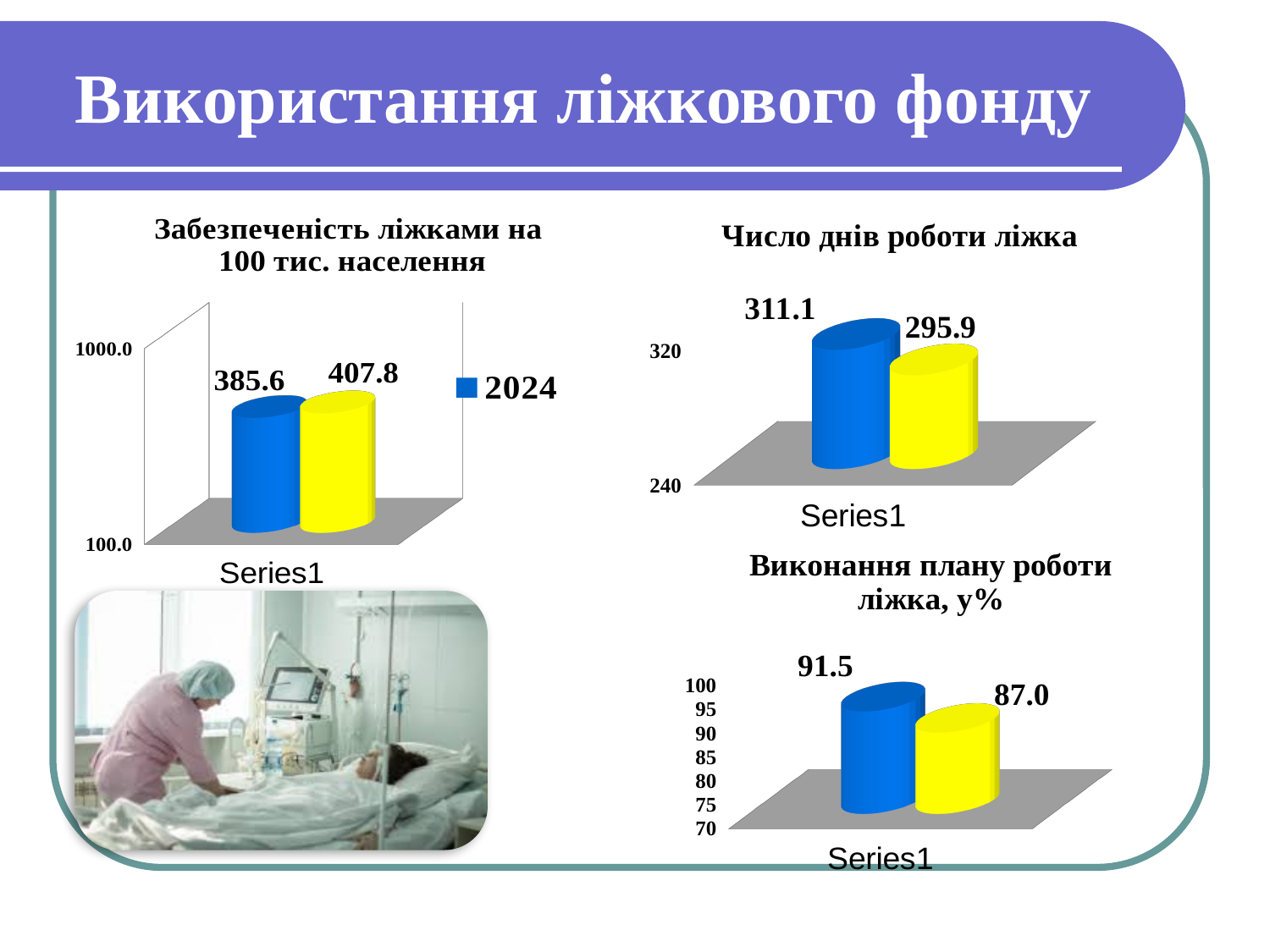
In the chart titled "Число днів роботи ліжка", what is the value shown on the blue bar? 311.1 In the chart titled "Виконання плану роботи ліжка, у%", what is the difference between the blue bar and the yellow bar? 4.5 In the chart titled "Забезпеченість ліжками на 100 тис. населення", what is the difference between the yellow bar and the blue bar? 22.2 In the chart titled "Число днів роботи ліжка", which bar is higher, the blue one or the yellow one? the blue one In the chart titled "Виконання плану роботи ліжка, у%", what is the value shown on the yellow bar? 87.0 In the chart titled "Виконання плану роботи ліжка, у%", what is the value shown on the blue bar? 91.5 In the chart titled "Забезпеченість ліжками на 100 тис. населення", what is the value shown on the blue bar? 385.6 In the chart titled "Число днів роботи ліжка", what is the difference between the blue bar and the yellow bar? 15.2 How many bars are plotted in the chart titled "Виконання плану роботи ліжка, у%"? 2 In the chart titled "Забезпеченість ліжками на 100 тис. населення", what is the value shown on the yellow bar? 407.8 What year is shown in the legend of the chart titled "Забезпеченість ліжками на 100 тис. населення"? 2024 In the chart titled "Число днів роботи ліжка", what is the value shown on the yellow bar? 295.9